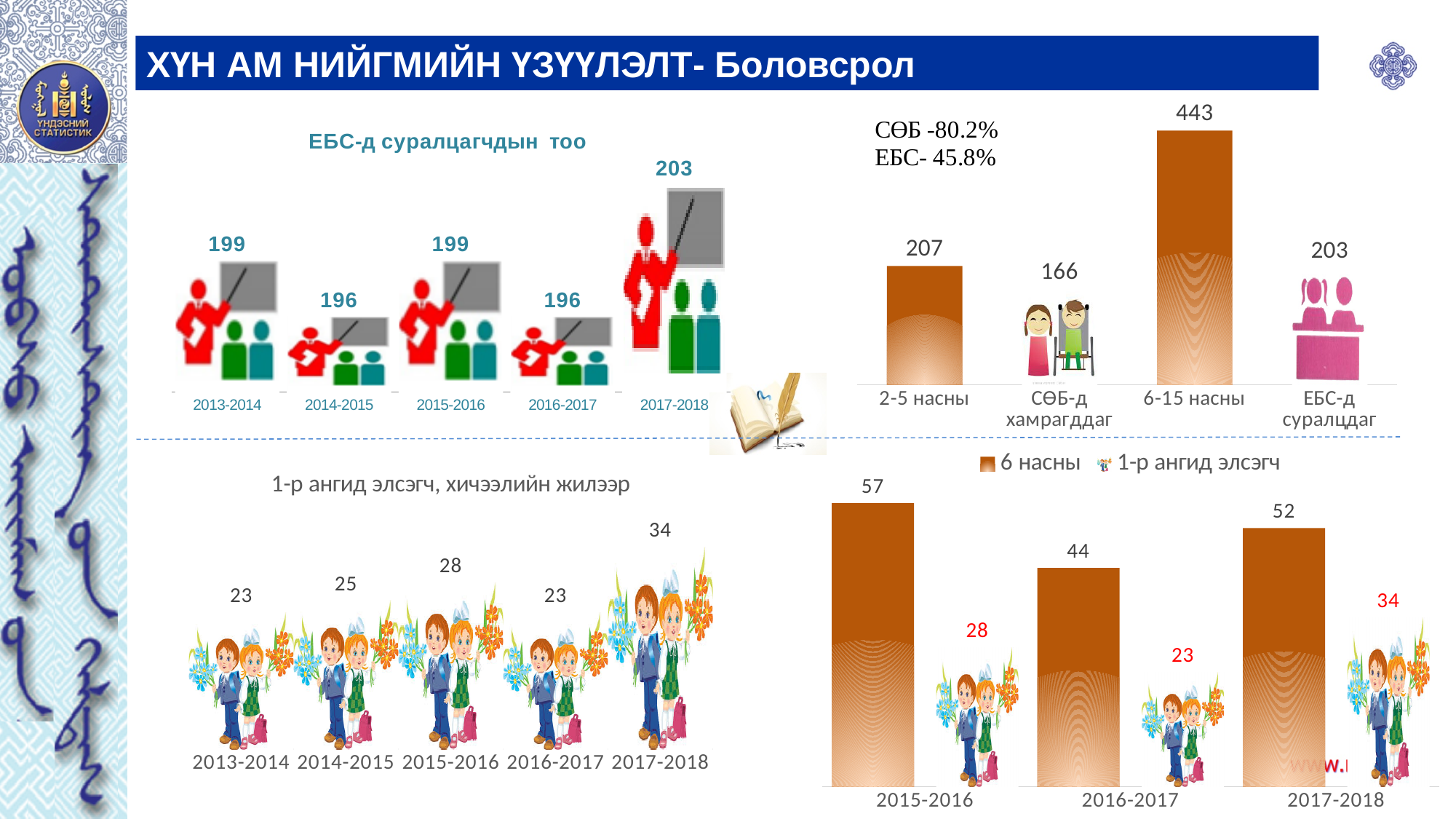
In the top-left chart 'ЕБС-д суралцагчдын тоо', how many school years are shown? 5 In the top-left chart 'ЕБС-д суралцагчдын тоо', which school year has the highest value? 2017-2018 In the bottom-left chart '1-р ангид элсэгч, хичээлийн жилээр', what is the value for 2015-2016? 28 In the bottom-right chart, what is the value of '6 насны' for 2016-2017? 44 In the top-right bar chart, what percentage is shown for СӨБ? 80.2% In the bottom-left chart '1-р ангид элсэгч, хичээлийн жилээр', which school year has the highest value? 2017-2018 In the top-left chart 'ЕБС-д суралцагчдын тоо', what is the value for 2017-2018? 203 In the top-right bar chart, which category has the lowest value? СӨБ-д хамрагддаг In the bottom-right chart, how many series does the legend list? 2 In the top-right bar chart, what is the value for '6-15 насны'? 443 In the top-right bar chart, what is the difference between '2-5 насны' and 'СӨБ-д хамрагддаг'? 41 In the bottom-right chart, what is the difference between '6 насны' and '1-р ангид элсэгч' for 2015-2016? 29